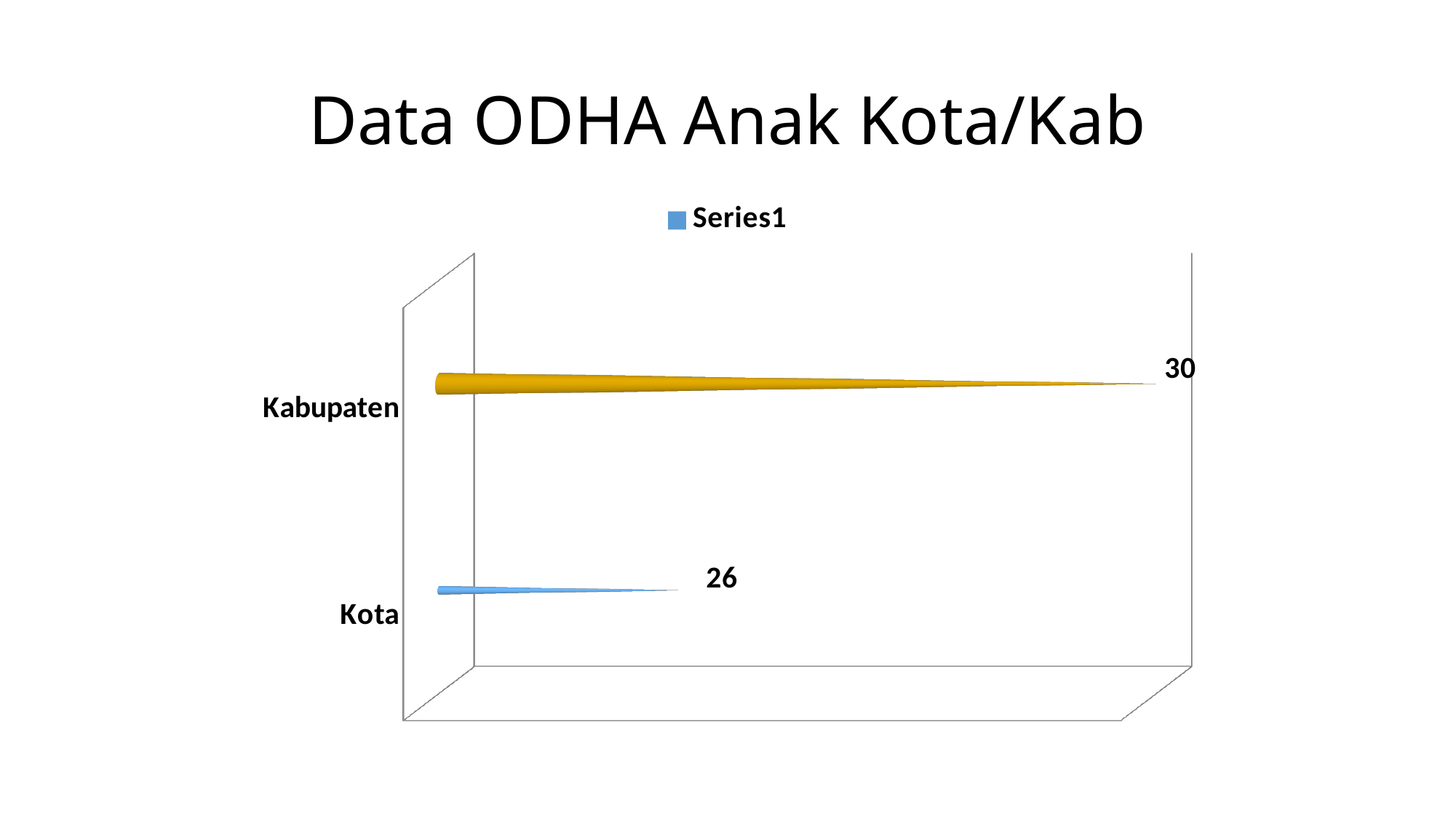
What kind of chart is shown on the slide? Bar chart Which category has the lowest value? Kota Which category has the highest value? Kabupaten What is the title of the slide? Data ODHA Anak Kota/Kab What is the difference between the values for Kabupaten and Kota? 4 Which is larger, the value for Kabupaten or the value for Kota? Kabupaten How many categories are shown in the chart? 2 How many series does the legend list? 1 What is the name of the series listed in the legend? Series1 What is the value for Kabupaten? 30 What is the value for Kota? 26